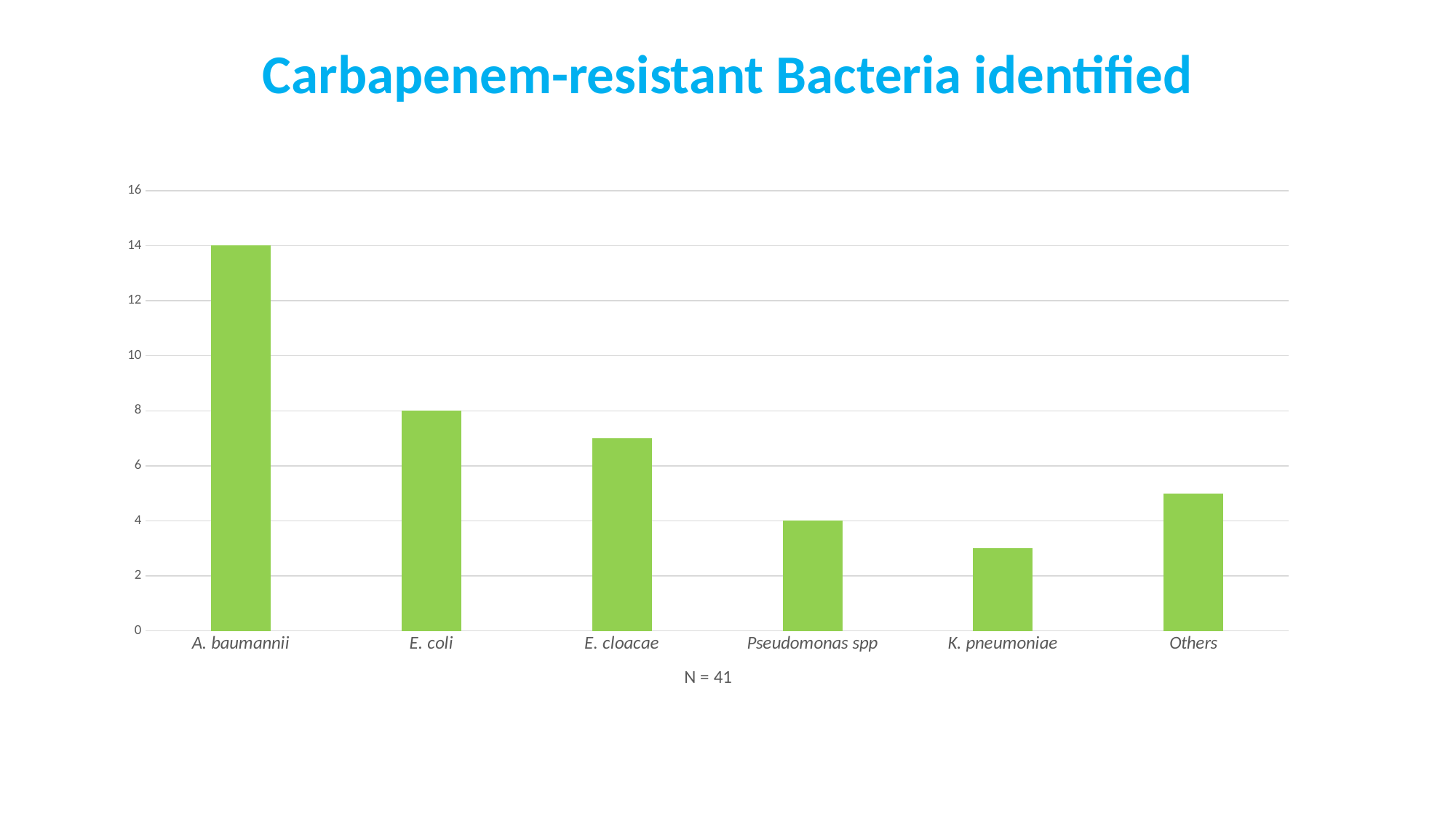
Is the value for E. cloacae greater or less than 6? greater Is the value for K. pneumoniae greater or less than 4? less What is the value for A. baumannii? 14 How many bacteria categories are shown on the x axis? 6 What is the value for E. coli? 8 What is the difference between the values for A. baumannii and E. coli? 6 What kind of chart is shown on the slide? bar chart What sample size (N) is stated below the chart? N = 41 Which bacterium has the highest bar? A. baumannii Which is larger, the value for E. coli or the value for Others? E. coli Which bacterium has the lowest bar? K. pneumoniae What is the value for Pseudomonas spp? 4